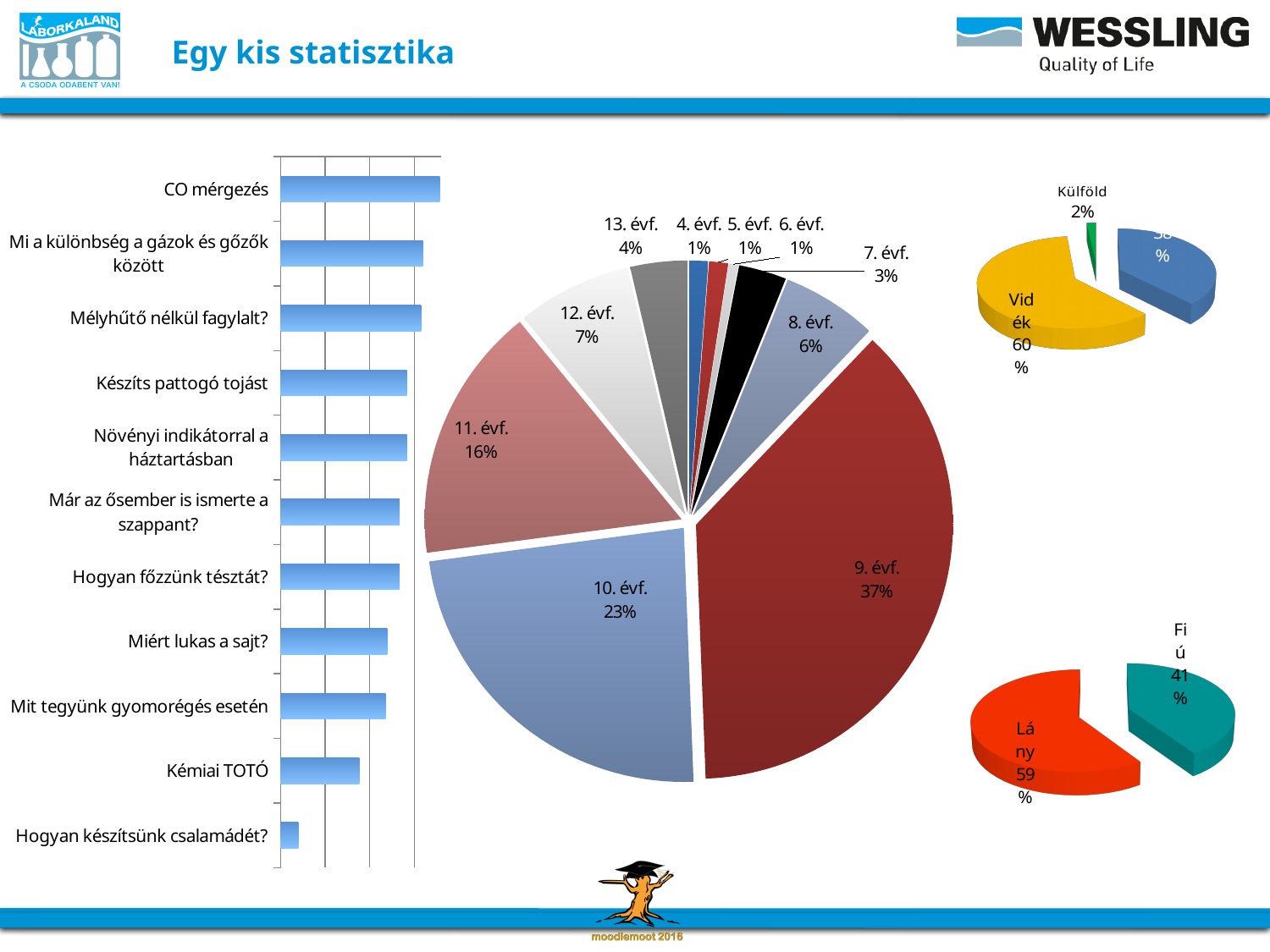
In the large pie chart in the centre of the slide, what share does 9. évf. have? 37% In the bar chart on the left side of the slide, which bar is longer: Kémiai TOTÓ or Miért lukas a sajt? Miért lukas a sajt? In the small pie chart at the top right of the slide, what share does Külföld have? 2% How many slices does the large pie chart in the centre of the slide have? 10 In the small pie chart at the bottom right of the slide, what share does Lány have? 59% How many categories does the bar chart on the left side of the slide show? 11 In the large pie chart in the centre of the slide, which slice is the largest? 9. évf. In the bar chart on the left side of the slide, which category has the longest bar? CO mérgezés What kind of chart is the chart on the left side of the slide? bar chart In the large pie chart in the centre of the slide, what is the difference in percentage points between 9. évf. and 10. évf.? 14 In the bar chart on the left side of the slide, which category has the shortest bar? Hogyan készítsünk csalamádét?